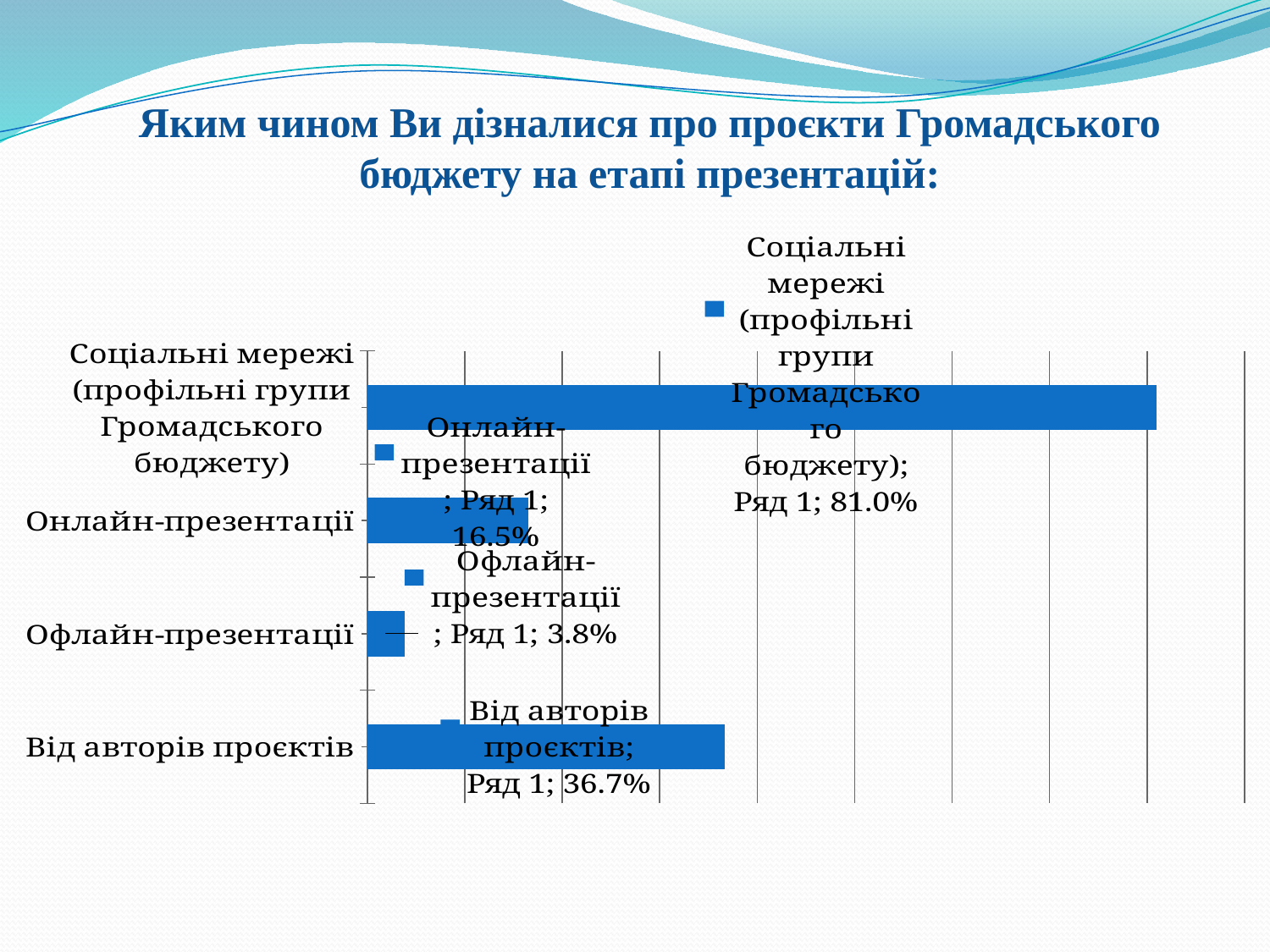
What type of chart is shown on the slide? Bar chart Which category has the lowest value? Офлайн-презентації How many categories are shown in the chart? 4 What is the value for Офлайн-презентації? 3.8% Which is larger: the value for Від авторів проєктів or the value for Онлайн-презентації? Від авторів проєктів What is the name of the data series shown in the chart's data labels? Ряд 1 Which category has the highest value? Соціальні мережі (профільні групи Громадського бюджету) What is the value for Соціальні мережі (профільні групи Громадського бюджету)? 81.0% What is the difference between the values for Соціальні мережі (профільні групи Громадського бюджету) and Від авторів проєктів? 44.3% What is the value for Онлайн-презентації? 16.5% What is the value for Від авторів проєктів? 36.7% What is the difference between the values for Онлайн-презентації and Офлайн-презентації? 12.7%